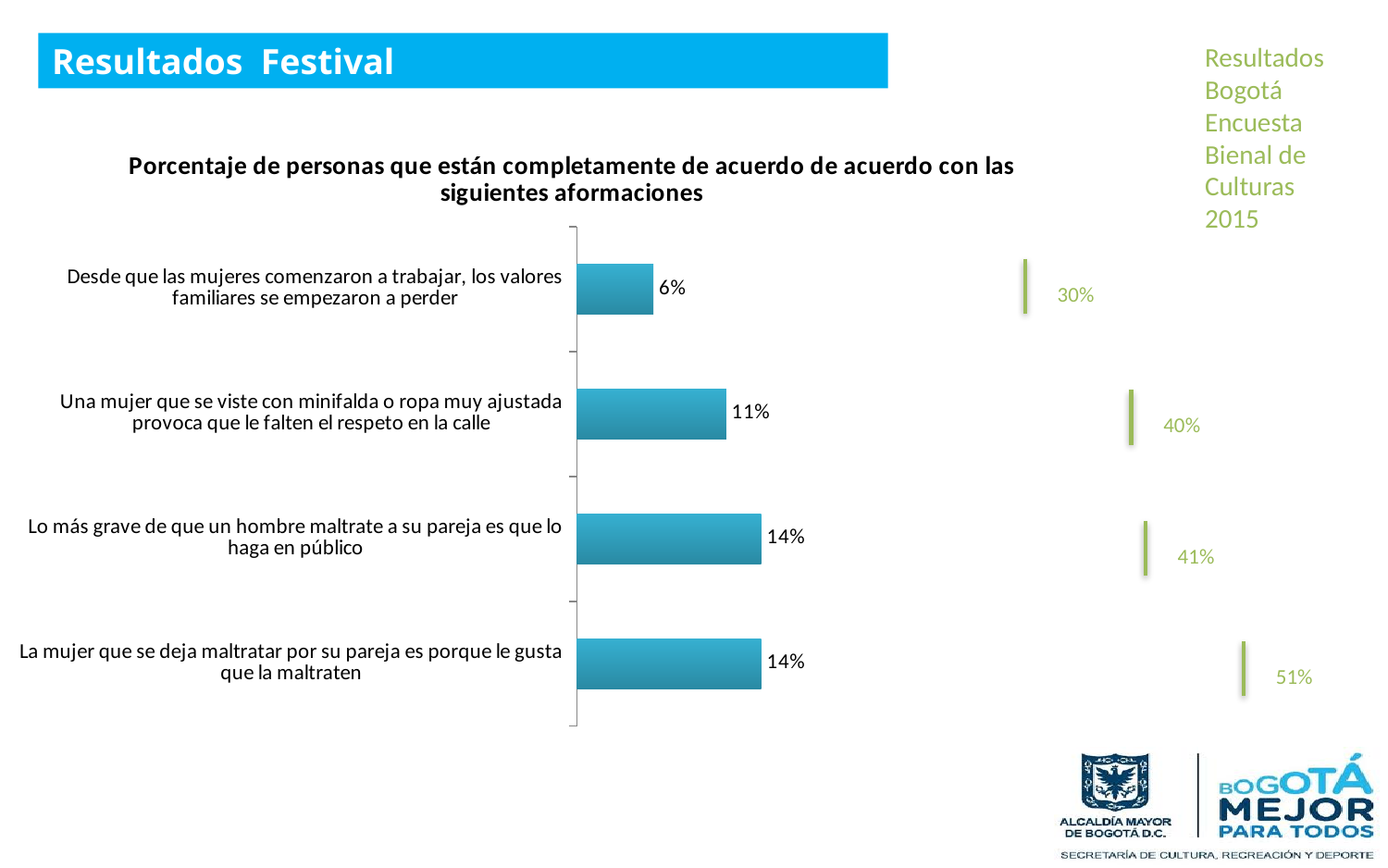
What is the value of the blue bar for "Desde que las mujeres comenzaron a trabajar, los valores familiares se empezaron a perder"? 6% What is the value of the blue bar for "Una mujer que se viste con minifalda o ropa muy ajustada provoca que le falten el respeto en la calle"? 11% How many statements (categories) are shown in the chart? 4 Which statement has the lowest blue bar value? Desde que las mujeres comenzaron a trabajar, los valores familiares se empezaron a perder What is the green Bogotá Encuesta Bienal de Culturas 2015 value shown for "Desde que las mujeres comenzaron a trabajar, los valores familiares se empezaron a perder"? 30% Which statement has the highest green Bogotá Encuesta Bienal de Culturas 2015 value? La mujer que se deja maltratar por su pareja es porque le gusta que la maltraten What is the difference between the blue bar values for "La mujer que se deja maltratar por su pareja es porque le gusta que la maltraten" and "Desde que las mujeres comenzaron a trabajar, los valores familiares se empezaron a perder"? 8 percentage points What kind of chart is shown on the slide? Bar chart Which is larger: the blue bar for "Una mujer que se viste con minifalda o ropa muy ajustada provoca que le falten el respeto en la calle" or the blue bar for "Desde que las mujeres comenzaron a trabajar, los valores familiares se empezaron a perder"? Una mujer que se viste con minifalda o ropa muy ajustada provoca que le falten el respeto en la calle What is the title of the chart? Porcentaje de personas que están completamente de acuerdo de acuerdo con las siguientes aformaciones What is the value of the blue bar for "Lo más grave de que un hombre maltrate a su pareja es que lo haga en público"? 14% What is the green Bogotá Encuesta Bienal de Culturas 2015 value shown for "La mujer que se deja maltratar por su pareja es porque le gusta que la maltraten"? 51%